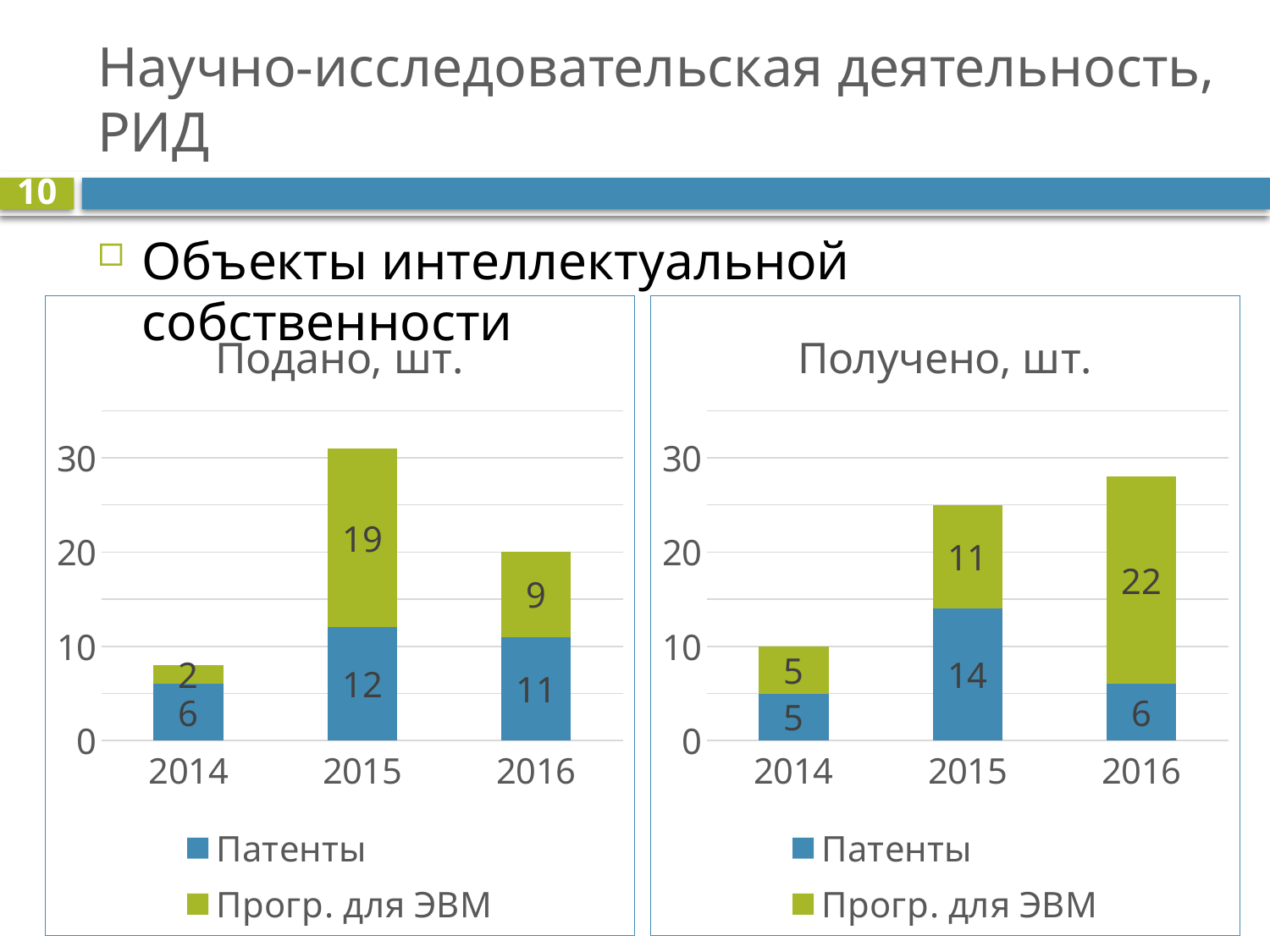
In the "Получено, шт." chart, what is the value for Прогр. для ЭВМ in 2016? 22 In the "Получено, шт." chart, what is the difference between Патенты in 2015 and Патенты in 2016? 8 In the "Подано, шт." chart, what is the total of the stacked bar for 2015? 31 In the "Получено, шт." chart, what is the value for Патенты in 2014? 5 In the "Подано, шт." chart, what is the value for Патенты in 2015? 12 What kind of chart is the "Подано, шт." chart? Stacked bar chart In the "Подано, шт." chart, which is larger: Патенты in 2016 or Прогр. для ЭВМ in 2016? Патенты in 2016 In the "Получено, шт." chart, what is the total of the stacked bar for 2016? 28 In the "Подано, шт." chart, what is the value for Прогр. для ЭВМ in 2016? 9 How many series does the legend of the "Получено, шт." chart list? 2 In the "Подано, шт." chart, which year has the highest value for Прогр. для ЭВМ? 2015 In the "Получено, шт." chart, which year has the lowest value for Патенты? 2014